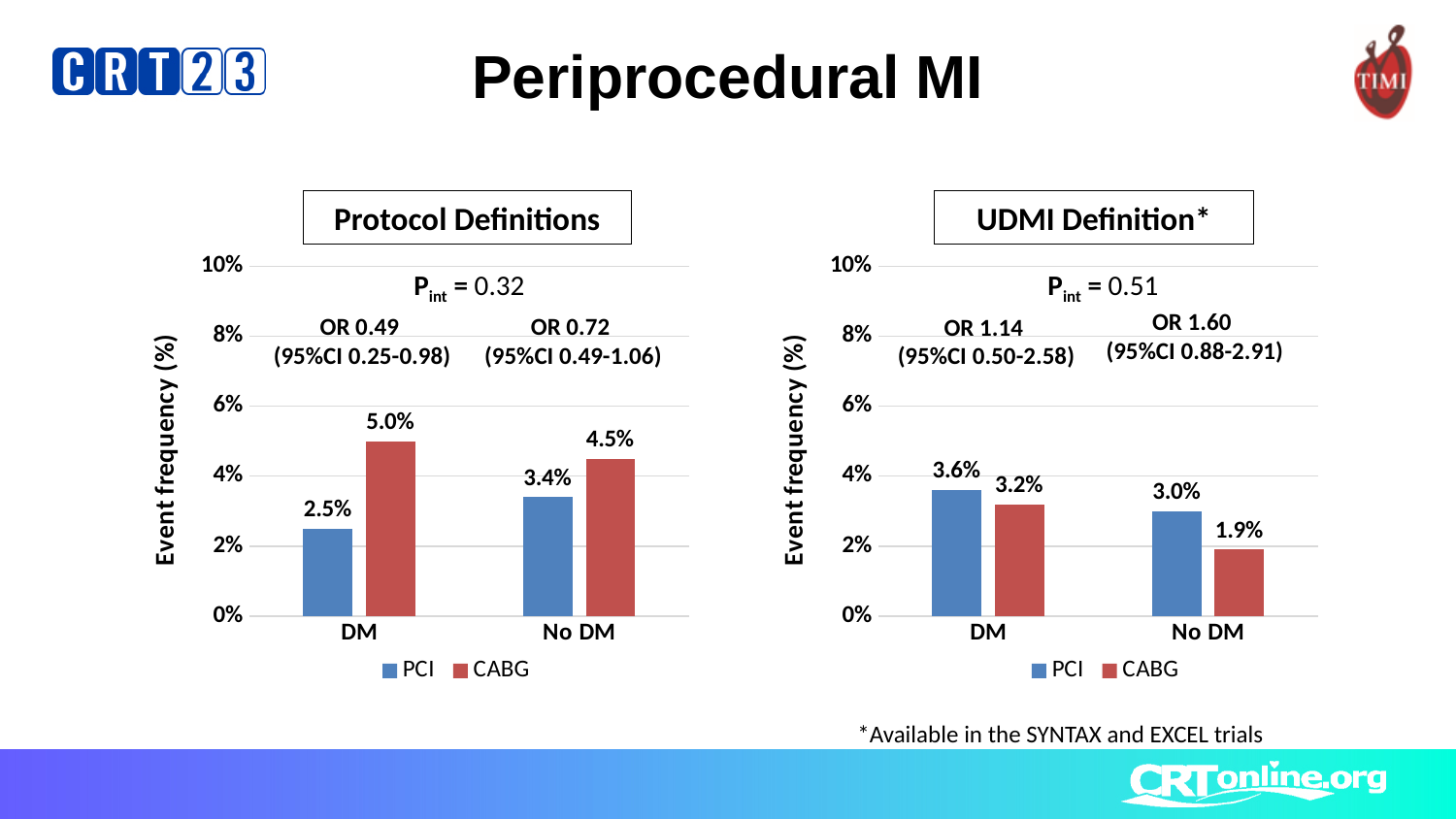
In the UDMI Definition chart, what is the event frequency for PCI in the DM group? 3.6% How many series does the legend list in the Protocol Definitions chart? 2 In the UDMI Definition chart, what is the event frequency for CABG in the No DM group? 1.9% In the UDMI Definition chart, is the event frequency higher for PCI or CABG in the No DM group? PCI What type of chart is the UDMI Definition chart? Bar chart In the Protocol Definitions chart, which bar has the highest event frequency? CABG in the DM group In the UDMI Definition chart, what is the difference between the PCI and CABG event frequencies in the No DM group? 1.1% In the UDMI Definition chart, which bar has the lowest event frequency? CABG in the No DM group What is the P-int value shown on the UDMI Definition chart? 0.51 In the Protocol Definitions chart, what is the event frequency for CABG in the DM group? 5.0% In the Protocol Definitions chart, what is the event frequency for PCI in the No DM group? 3.4% In the Protocol Definitions chart, what is the difference between the CABG and PCI event frequencies in the DM group? 2.5%